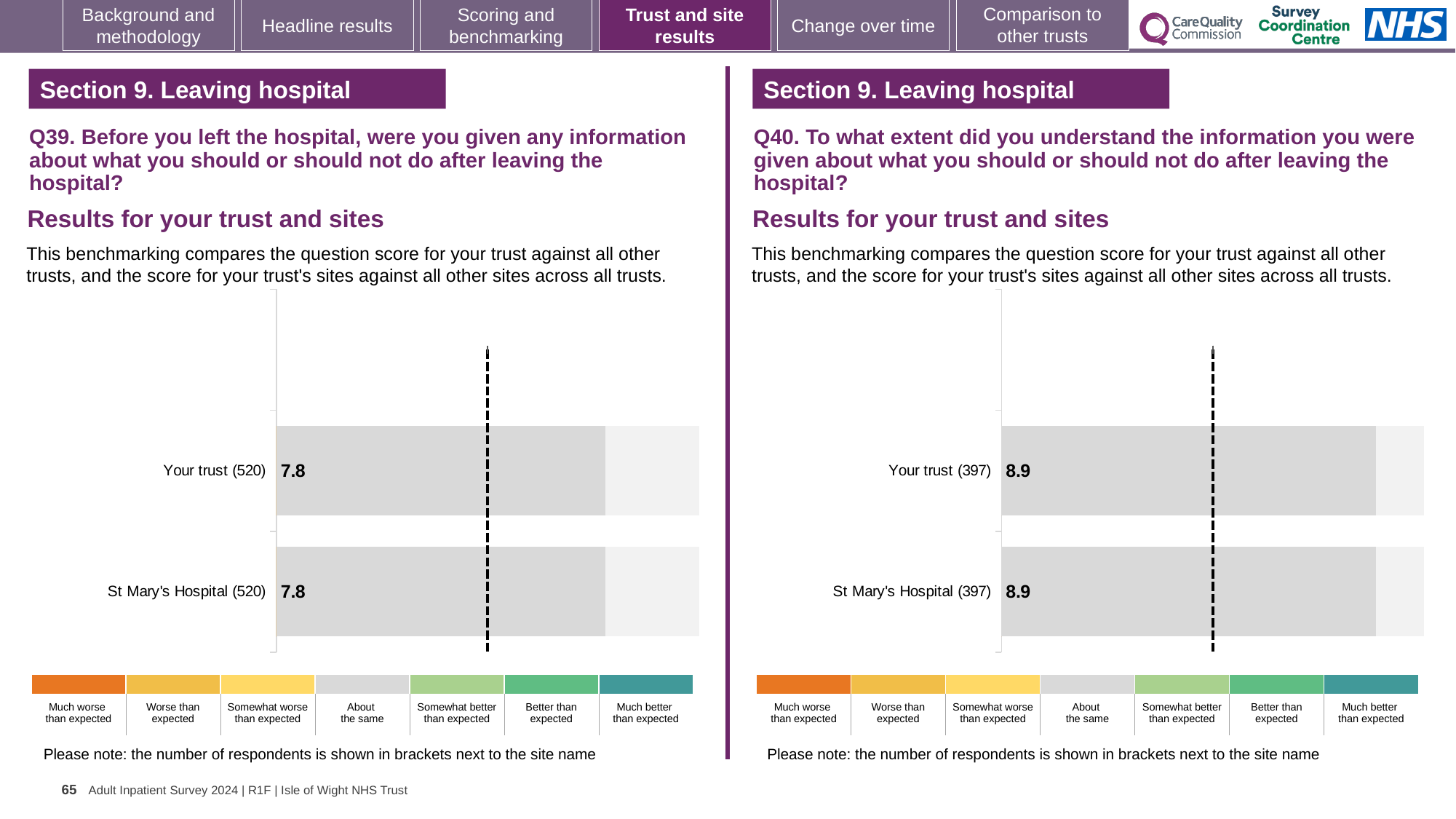
How many bars are plotted in the Q40 chart on the right? 2 In the Q40 chart on the right, what is the score for St Mary's Hospital? 8.9 How many bars are plotted in the Q39 chart on the left? 2 In the Q40 chart on the right, what is the difference between the scores for Your trust and St Mary's Hospital? 0 Is the score for Your trust in the Q40 chart on the right larger or smaller than the score for Your trust in the Q39 chart on the left? Larger In the Q39 chart on the left, what is the score for St Mary's Hospital? 7.8 What kind of chart is used for the Q39 results on the left? Bar chart In the Q39 chart on the left, what is the score for Your trust? 7.8 In the Q40 chart on the right, how many respondents are shown in brackets next to St Mary's Hospital? 397 In the Q40 chart on the right, what is the score for Your trust? 8.9 In the Q39 chart on the left, what is the difference between the scores for Your trust and St Mary's Hospital? 0 In the Q39 chart on the left, how many respondents are shown in brackets next to Your trust? 520